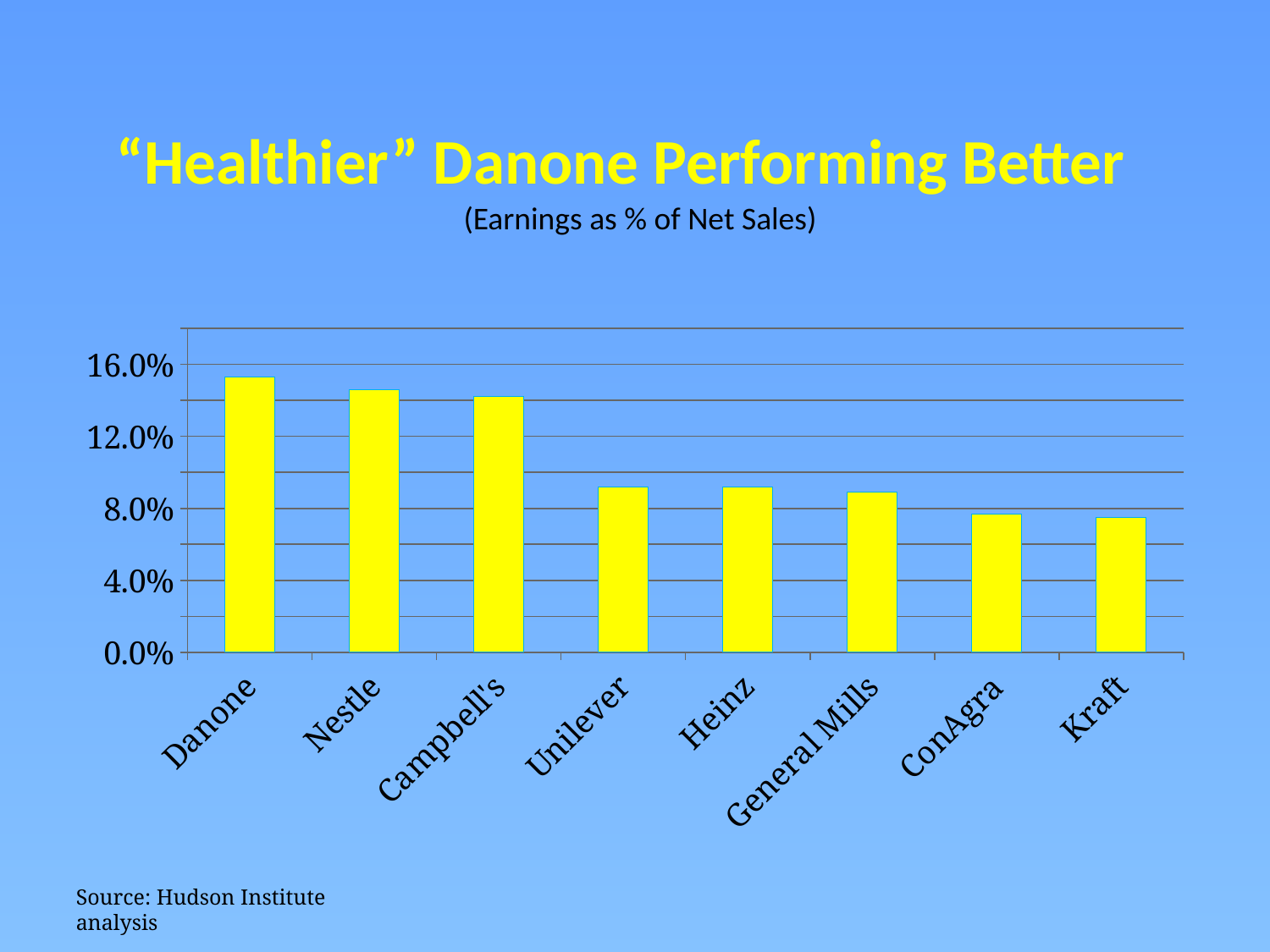
What is the title of the slide's chart? "Healthier" Danone Performing Better Do the values generally rise or fall moving from left to right along the x axis? fall Which has a higher value, Campbell's or Kraft? Campbell's Is the value for Unilever greater or less than 8.0%? greater Which company has the highest earnings as % of net sales? Danone Is the value for Nestle greater or less than 12.0%? greater How many companies are shown on the x axis of the chart? 8 Which has a higher value, Danone or Unilever? Danone Is the value for Kraft greater or less than 8.0%? less What kind of chart is shown on the slide? bar chart